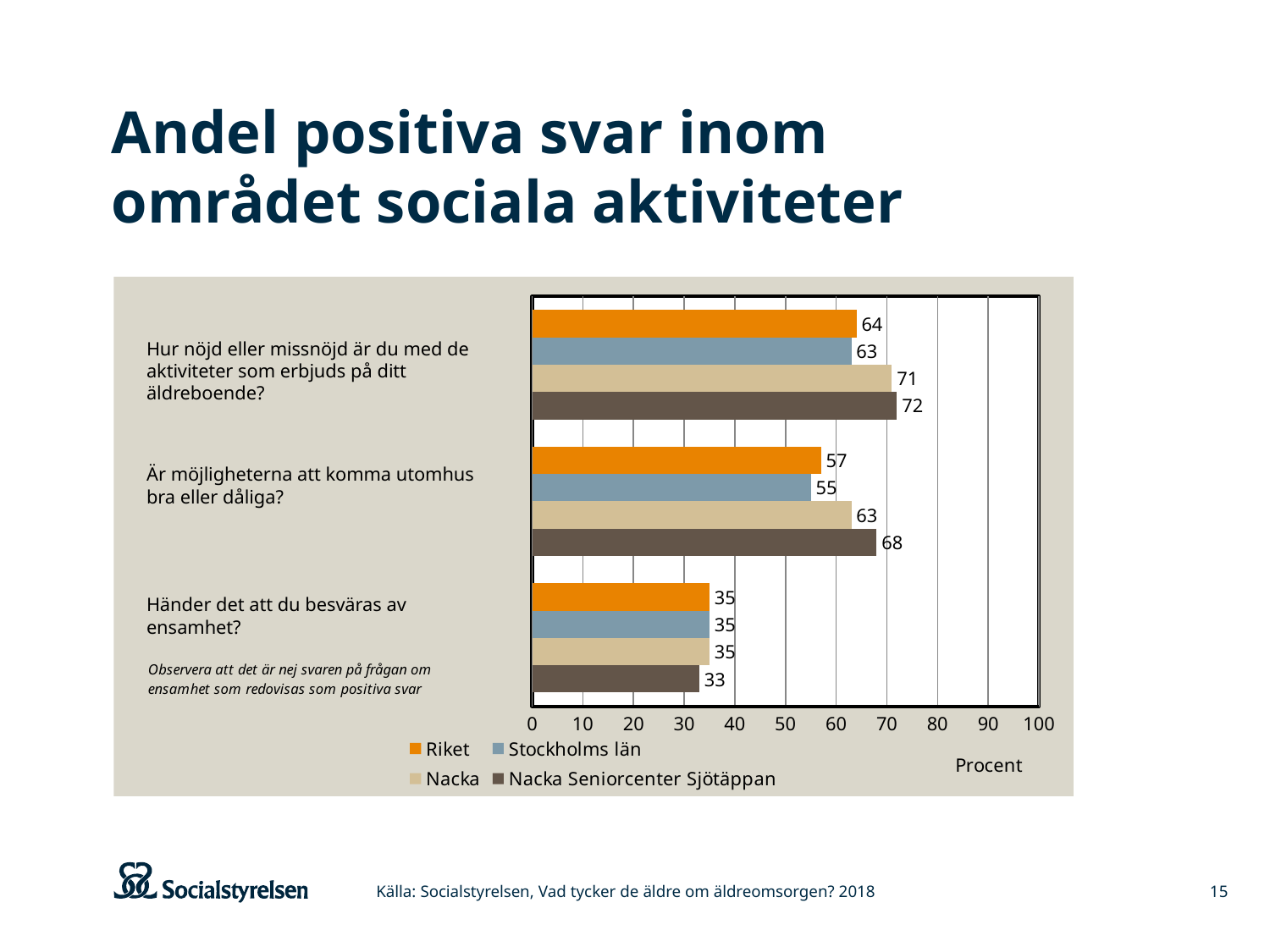
What is the label of the x axis? Procent How many series does the legend list? 4 What is the difference between Nacka and Stockholms län for the question 'Är möjligheterna att komma utomhus bra eller dåliga?'? 8 How many question categories are plotted on the chart? 3 What kind of chart is shown on the slide? Bar chart What is the difference between Nacka Seniorcenter Sjötäppan and Riket for the question 'Är möjligheterna att komma utomhus bra eller dåliga?'? 11 Which series has the highest value for the question 'Är möjligheterna att komma utomhus bra eller dåliga?'? Nacka Seniorcenter Sjötäppan Which series has the lowest value for the question 'Händer det att du besväras av ensamhet?'? Nacka Seniorcenter Sjötäppan What is the value for Riket for the question 'Är möjligheterna att komma utomhus bra eller dåliga?'? 57 For the question 'Hur nöjd eller missnöjd är du med de aktiviteter som erbjuds på ditt äldreboende?', which is larger: Nacka or Stockholms län? Nacka What is the value for Nacka Seniorcenter Sjötäppan for the question 'Hur nöjd eller missnöjd är du med de aktiviteter som erbjuds på ditt äldreboende?'? 72 What is the value for Stockholms län for the question 'Händer det att du besväras av ensamhet?'? 35